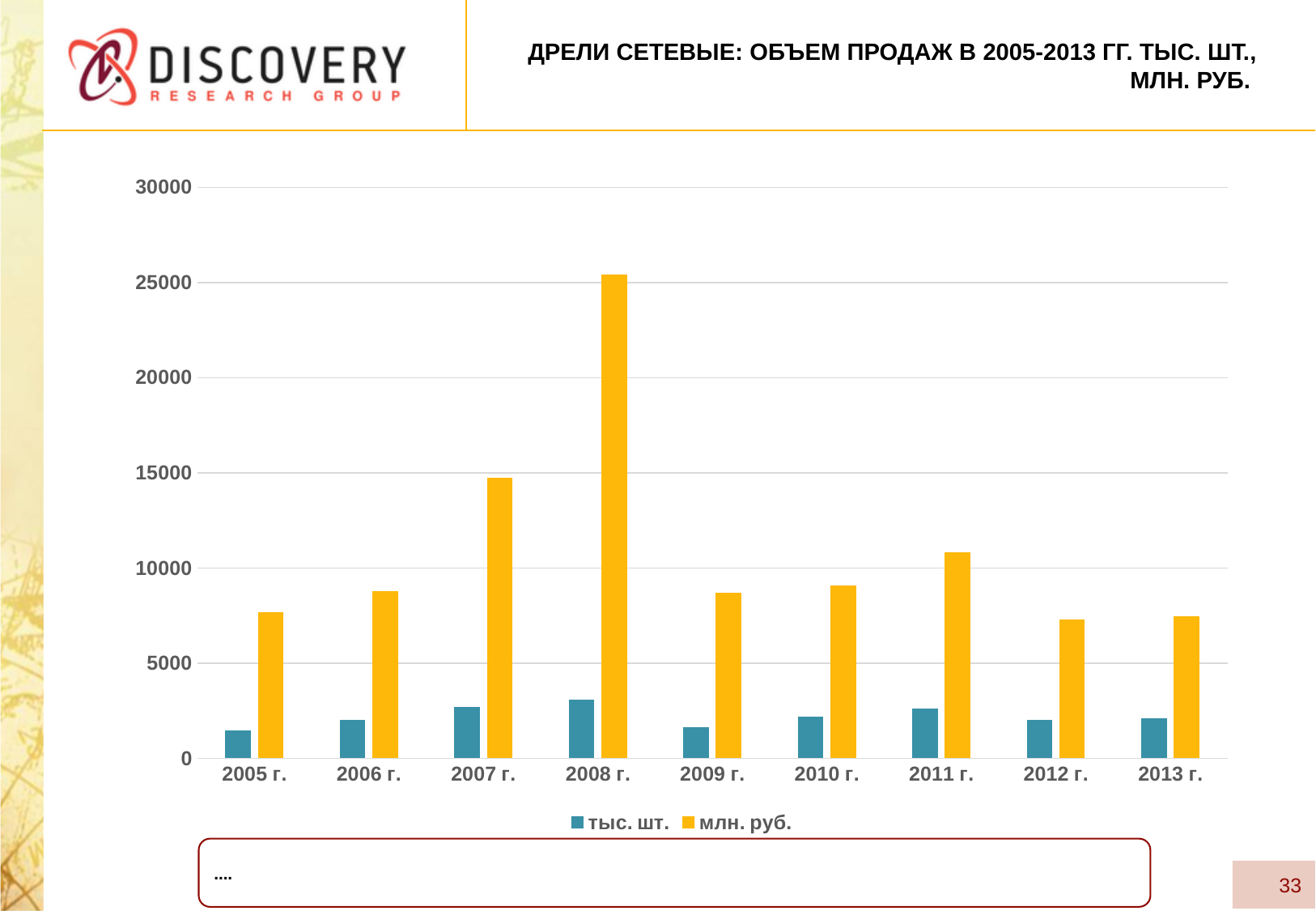
How many years are shown on the x axis? 9 Which year has the larger млн. руб. value, 2007 г. or 2011 г.? 2007 г. Is the тыс. шт. value for 2005 г. greater or less than 5000? less How many series does the legend list? 2 What kind of chart is shown on the slide? bar chart In which year is the млн. руб. value highest? 2008 г. Is the млн. руб. value for 2011 г. greater or less than 10000? greater Is the млн. руб. value for 2012 г. greater or less than 10000? less Do the млн. руб. values rise or fall from 2005 г. to 2008 г.? rise In which year is the тыс. шт. value highest? 2008 г. What colour are the млн. руб. bars? yellow